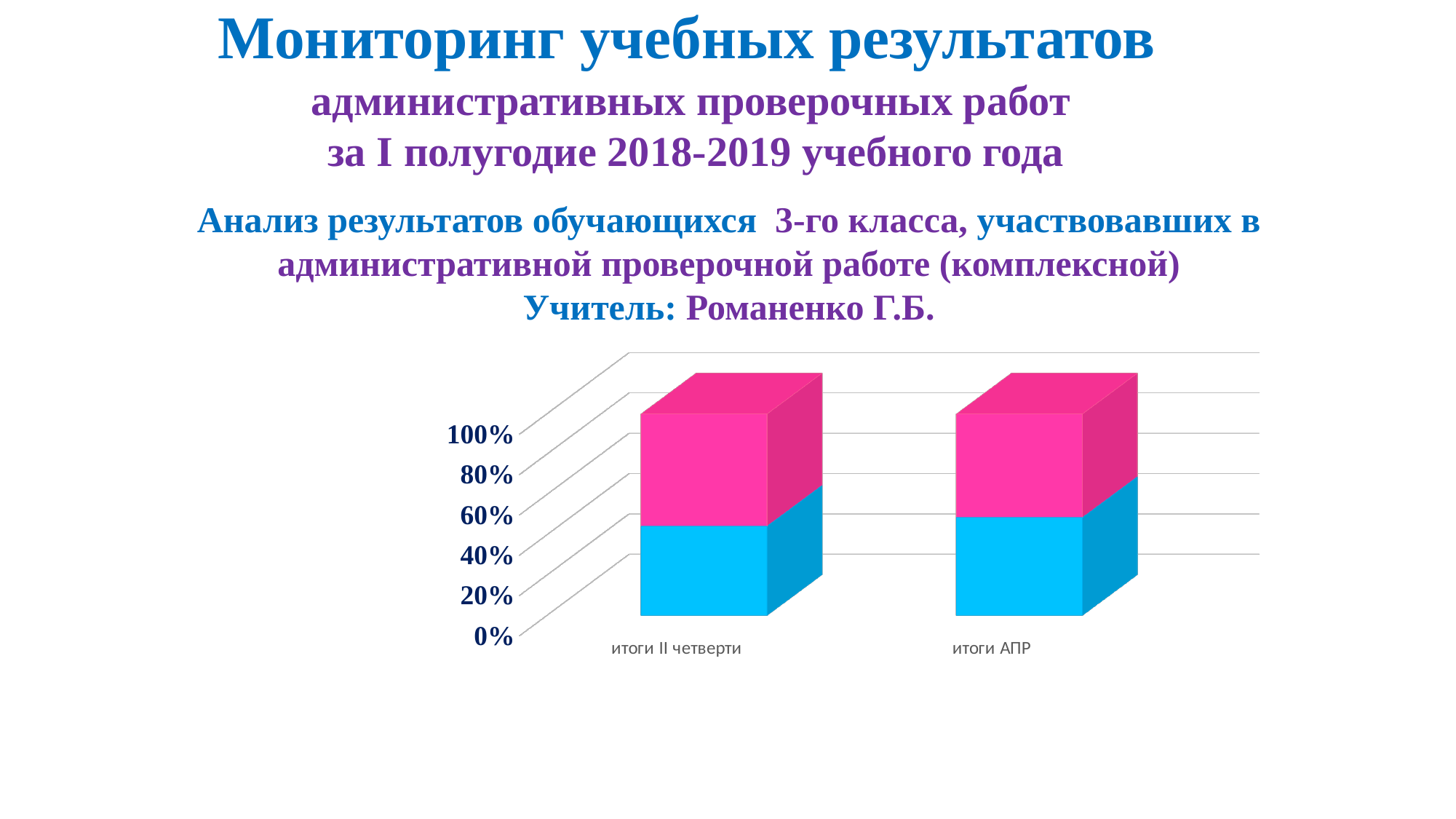
What kind of chart is shown on the slide? stacked bar chart What is the highest tick value shown on the vertical axis of the chart? 100% What are the two category labels on the x axis of the chart? итоги II четверти, итоги АПР Is the blue segment for итоги II четверти greater or less than 20%? greater How many categories are shown on the x axis of the chart? 2 Is the blue segment for итоги АПР greater or less than 20%? greater Is the blue segment for итоги II четверти greater or less than 80%? less